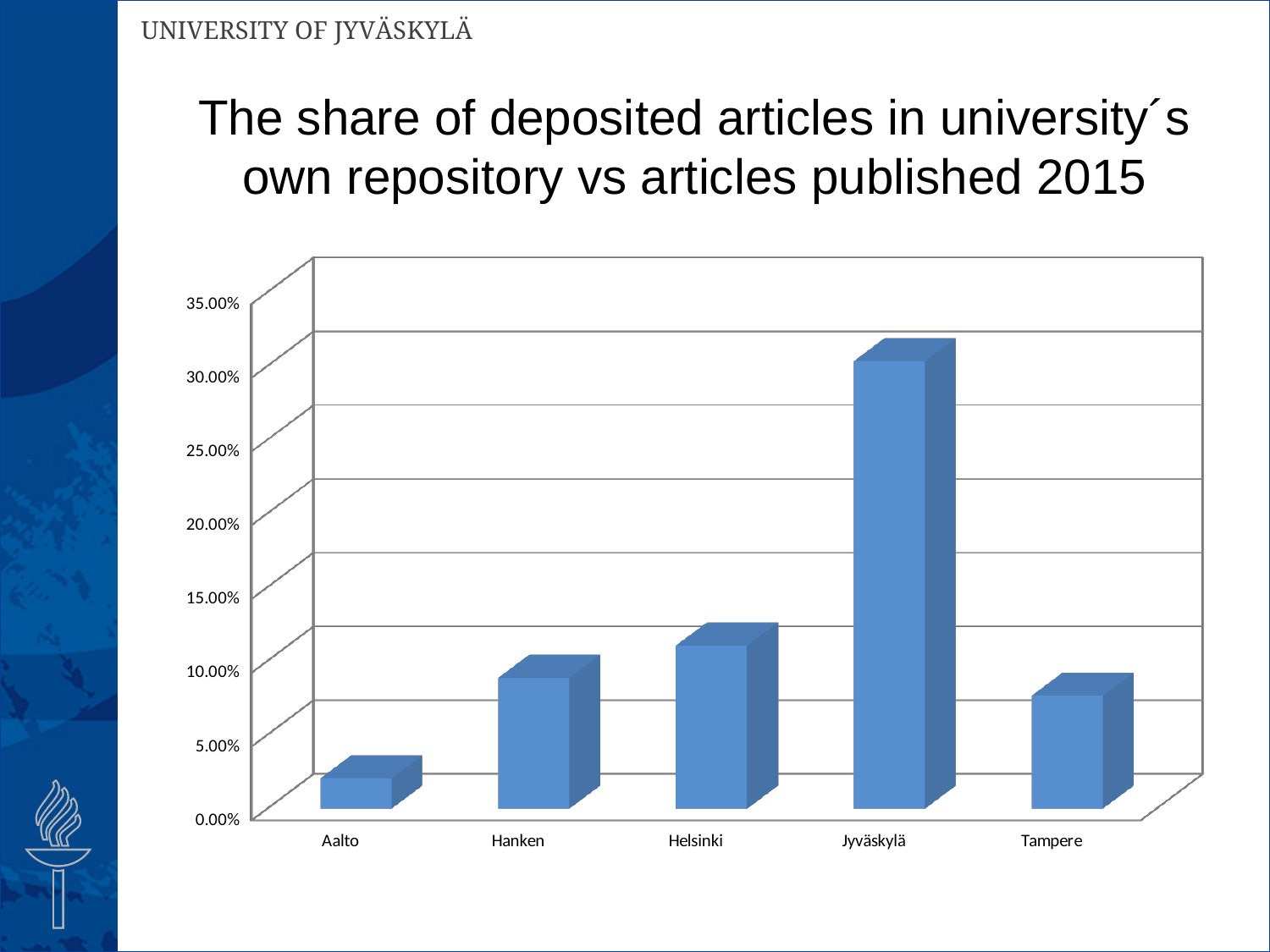
Which has the larger share, Aalto or Tampere? Tampere Which university has the highest share of deposited articles in the chart? Jyväskylä What is the title of the chart on the slide? The share of deposited articles in university´s own repository vs articles published 2015 Is the value for Jyväskylä greater or less than 25.00%? greater Is the value for Helsinki greater or less than 15.00%? less What kind of chart is shown on the slide? Bar chart How many universities are shown on the x axis of the chart? 5 Which university has the lowest share of deposited articles in the chart? Aalto Which has the larger share, Helsinki or Hanken? Helsinki Is the value for Tampere greater or less than 10.00%? less